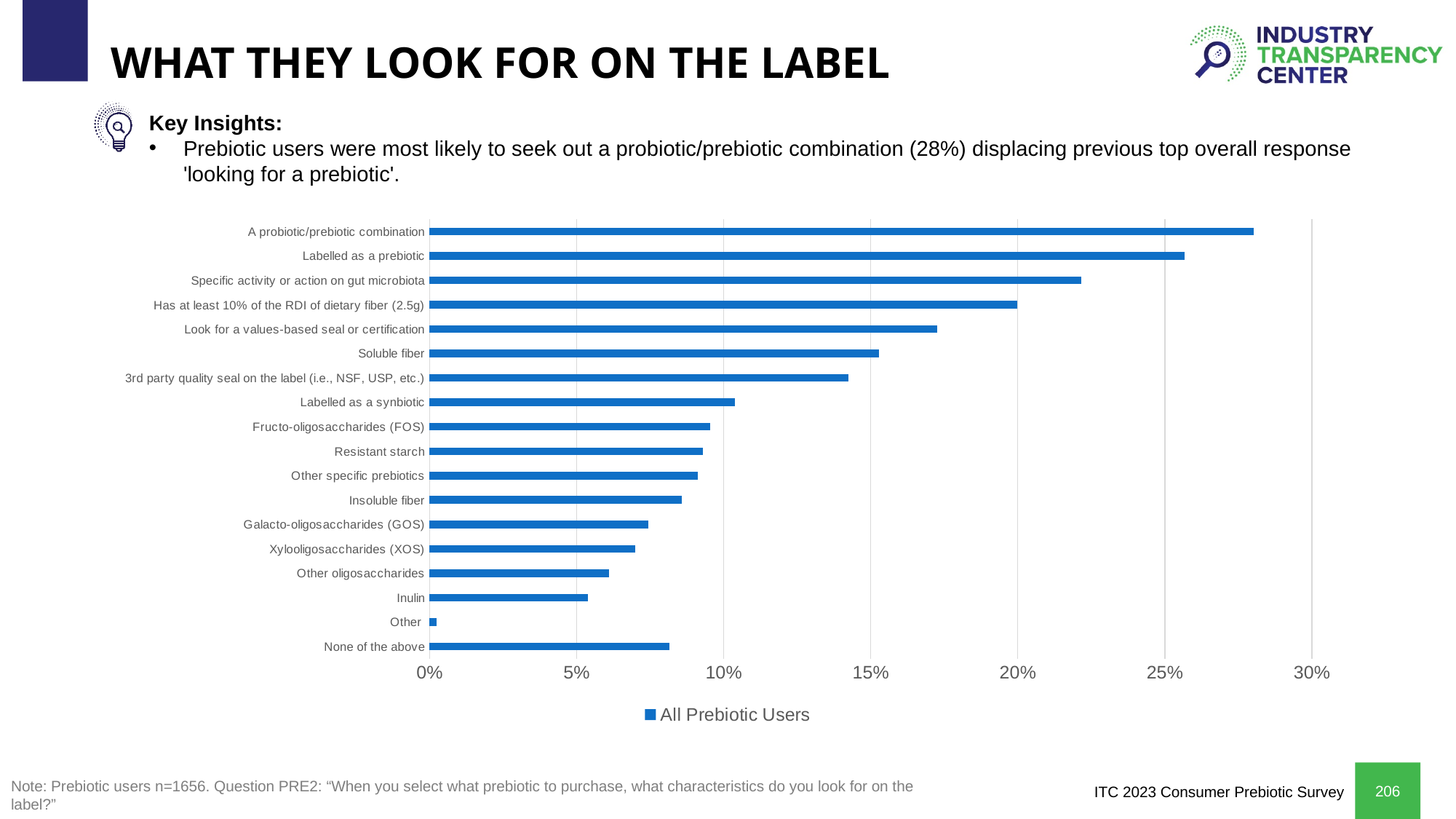
Which category has the highest value? A probiotic/prebiotic combination Is the value for 'Look for a values-based seal or certification' greater or less than 20%? less Is the value for 'None of the above' greater or less than 10%? less How many series does the legend list? 1 Which category has the lowest value? Other What kind of chart is shown on the slide? bar chart Is the value for 'Labelled as a prebiotic' greater or less than 25%? greater How many categories are plotted in the chart? 18 What percentage of prebiotic users look for a probiotic/prebiotic combination, according to the slide? 28% What is the name of the series shown in the legend? All Prebiotic Users Which is larger, the value for 'Inulin' or the value for 'None of the above'? None of the above